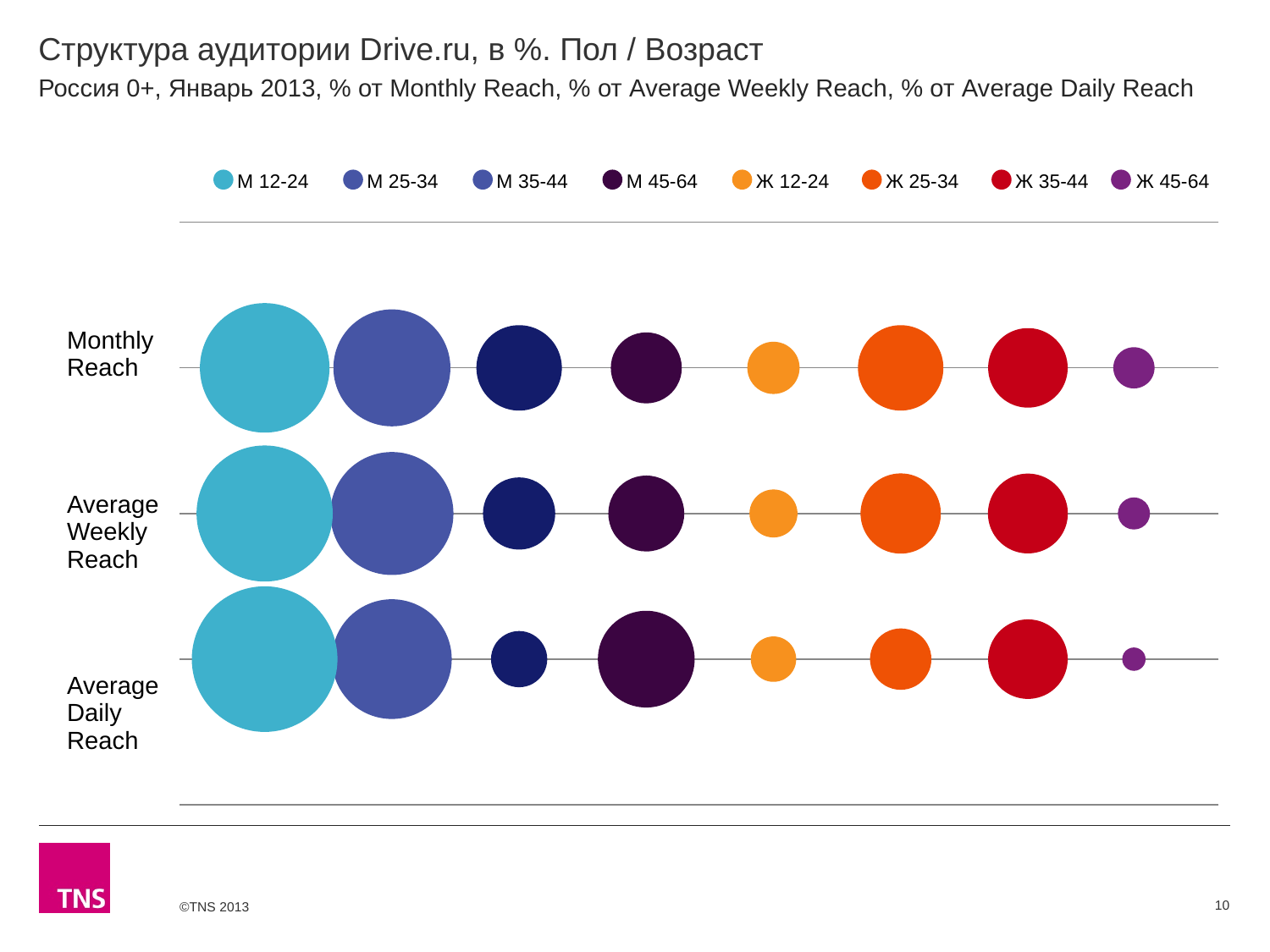
Does the bubble for М 35-44 get larger or smaller going from Monthly Reach to Average Daily Reach? Smaller Which audience group has the largest bubble in the Monthly Reach row? М 12-24 How many series does the legend list? 8 In the Monthly Reach row, which bubble is larger: Ж 12-24 or Ж 25-34? Ж 25-34 Which audience group has the smallest bubble in the Average Daily Reach row? Ж 45-64 What colour is the bubble for Ж 35-44? Red Which audience group has the smallest bubble in the Monthly Reach row? Ж 45-64 In the Average Daily Reach row, which bubble is larger: М 35-44 or М 45-64? М 45-64 What is the title of the chart on the slide? Структура аудитории Drive.ru, в %. Пол / Возраст What kind of chart is shown on the slide? Bubble chart Does the bubble for М 45-64 get larger or smaller going from Monthly Reach to Average Daily Reach? Larger How many reach rows (categories) are plotted on the chart? 3